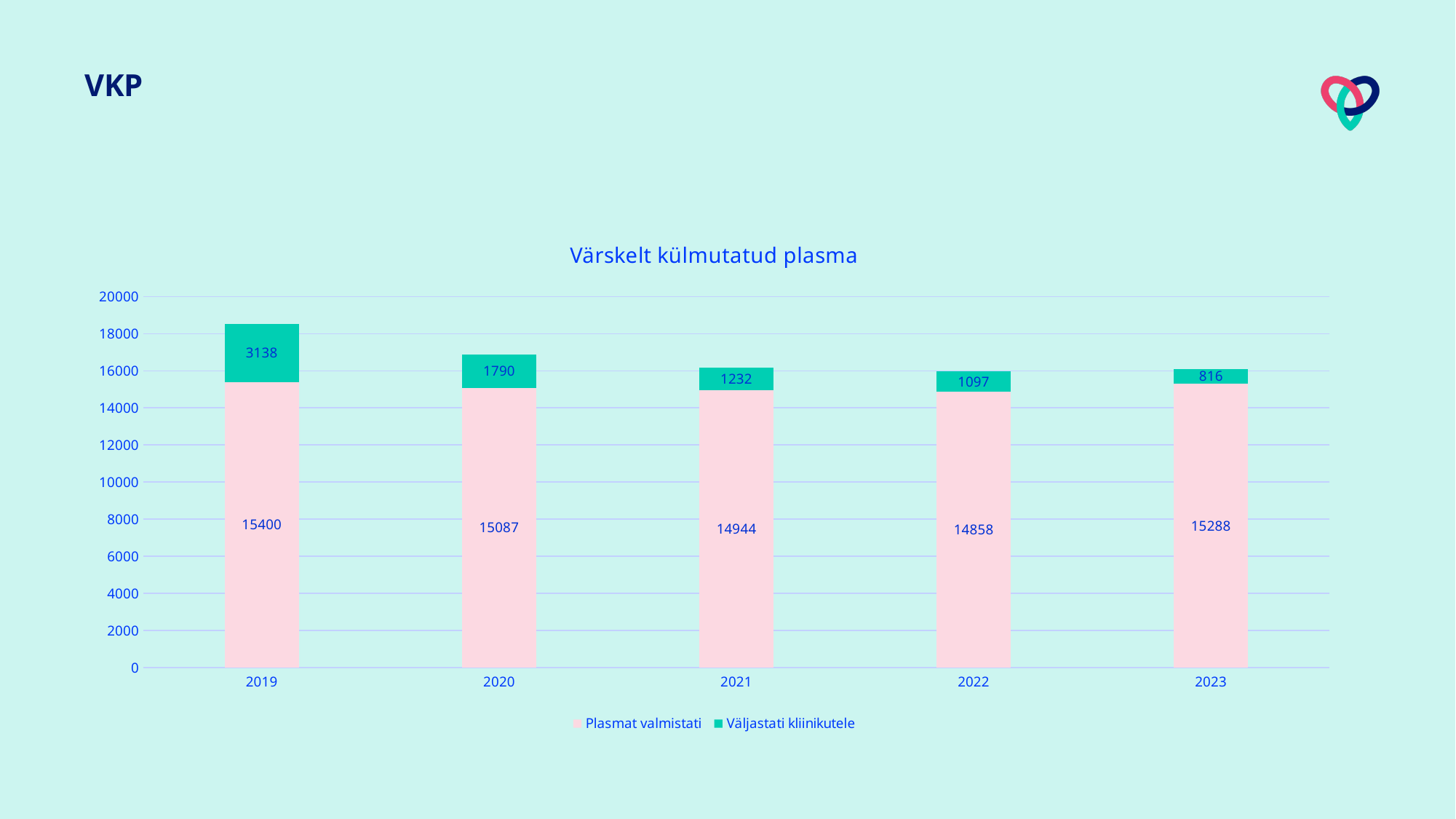
Which year has the lowest value for Plasmat valmistati? 2022 What is the difference between the Väljastati kliinikutele values for 2019 and 2020? 1348 How many years are shown on the x axis? 5 What is the total of the stacked bar for 2019? 18538 Which year has the highest value for Väljastati kliinikutele? 2019 What is the value of Väljastati kliinikutele for 2023? 816 What is the title of the chart? Värskelt külmutatud plasma What type of chart is shown on the slide? Stacked bar chart What is the value of Plasmat valmistati for 2019? 15400 How many series does the legend list? 2 Does the value of Väljastati kliinikutele rise or fall from 2019 to 2023? Fall Which is larger, the Plasmat valmistati value for 2020 or for 2023? 2023